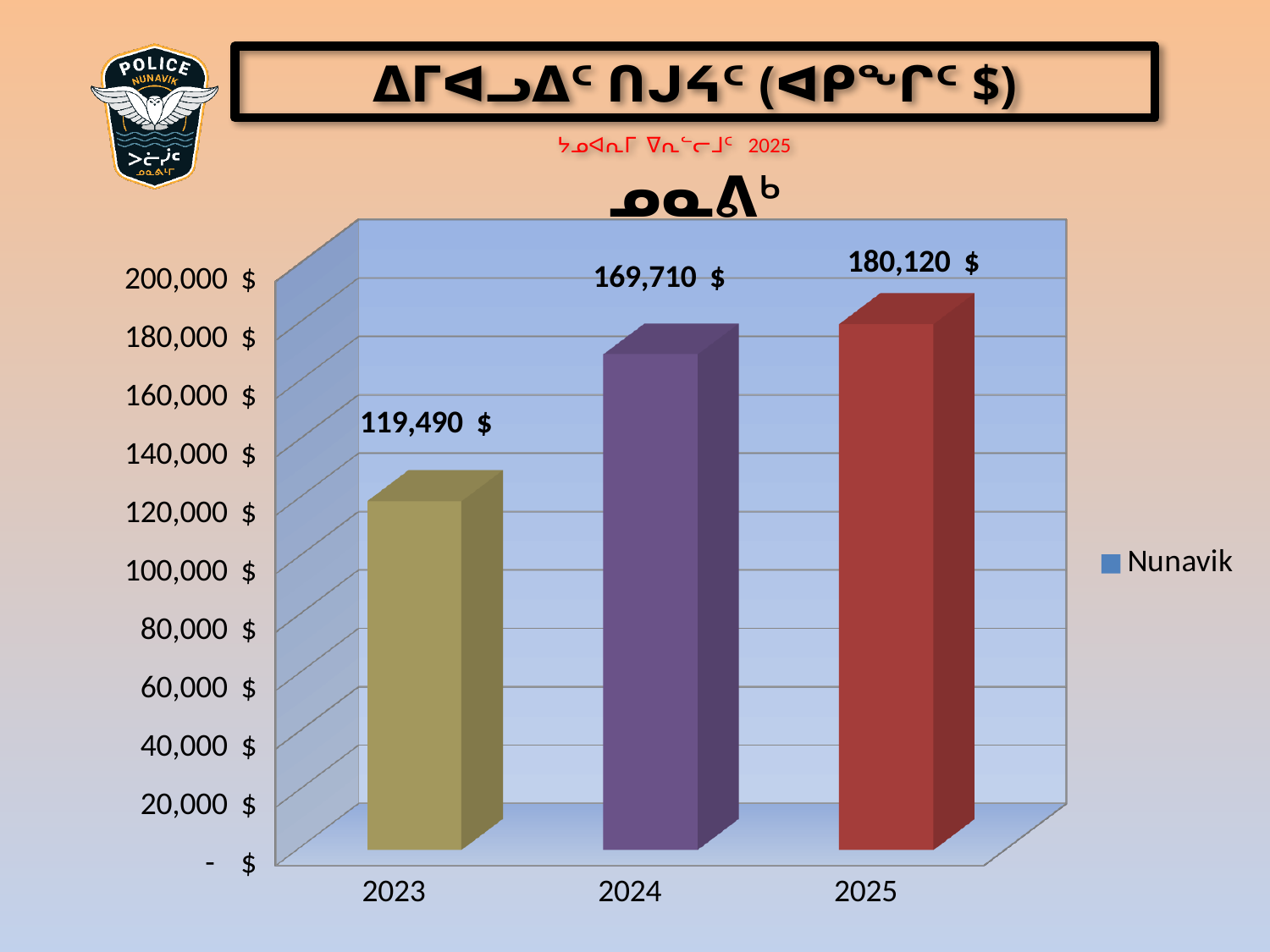
Which year has the lowest value? 2023 What is the value for 2025? 180,120 $ Do the values rise or fall from 2023 to 2025? rise What is the value for 2024? 169,710 $ Which is larger, the value for 2024 or the value for 2025? 2025 What is the value for 2023? 119,490 $ Which year has the highest value? 2025 What is the difference between the values for 2025 and 2023? 60,630 $ How many years are shown on the x axis? 3 What kind of chart is shown on the slide? bar chart Is the value for 2023 greater or less than 140,000 $? less What is the difference between the values for 2024 and 2023? 50,220 $